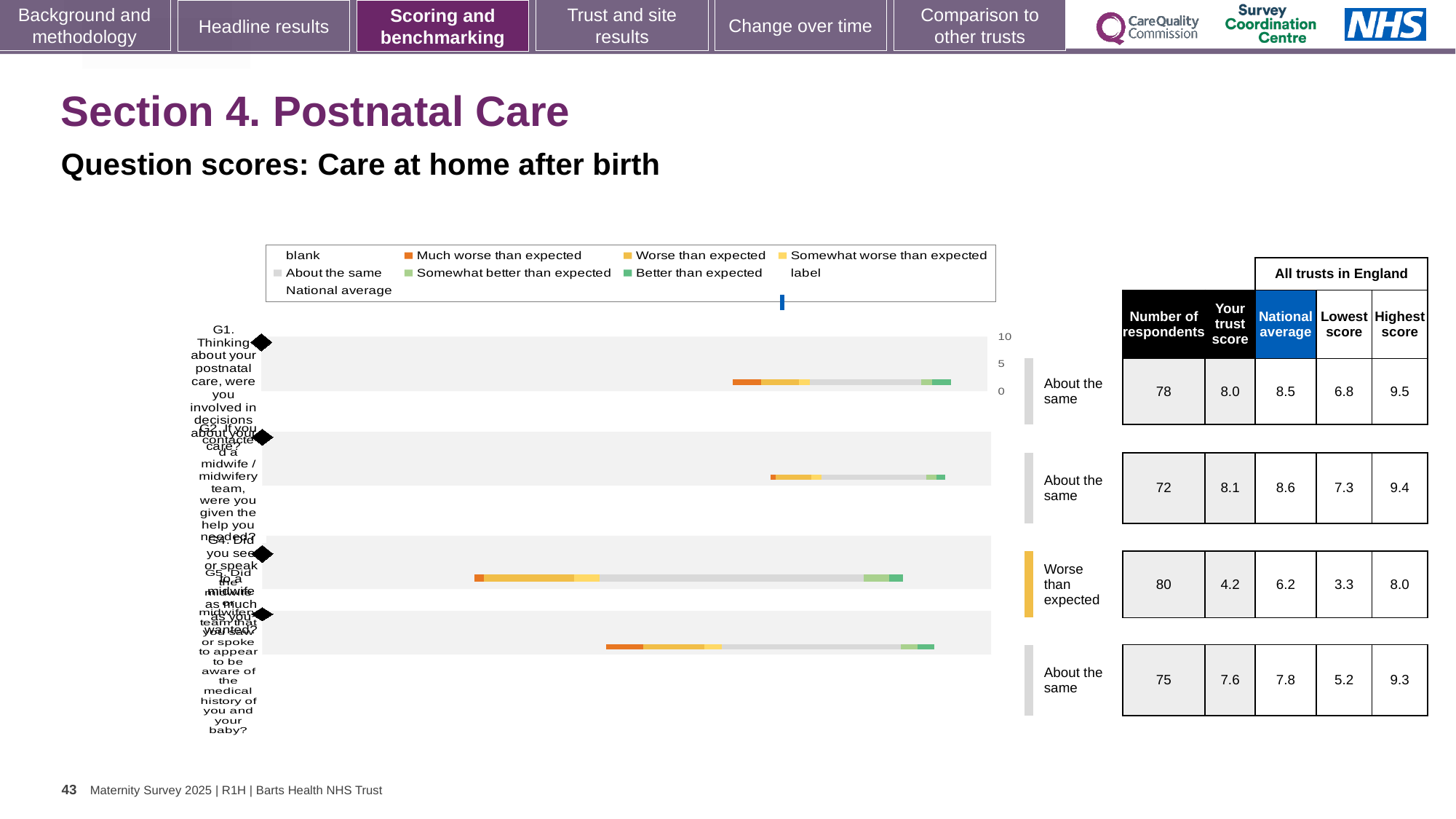
In the table beside the chart, what is the number of respondents for the first row? 78 What is the subtitle of the chart on the slide? Question scores: Care at home after birth Which row in the table beside the chart has the highest number of respondents? the third row (80) How many question bars are plotted in the chart? 4 In the table beside the chart, what is the highest score across all trusts in England for the fourth row? 9.3 In the table beside the chart, what is the national average for the row rated 'Worse than expected'? 6.2 Which row in the table beside the chart has the lowest 'Your trust score'? the third row (Worse than expected) How many of the four rows in the table beside the chart are rated 'About the same'? 3 In the table beside the chart, is the trust score for the first row (8.0) or the second row (8.1) larger? the second row (8.1) What kind of chart is shown on the slide? bar chart In the table beside the chart, what is the 'Your trust score' for the third row, rated 'Worse than expected'? 4.2 In the table beside the chart, what is the difference between the national average and the trust score for the row rated 'Worse than expected'? 2.0